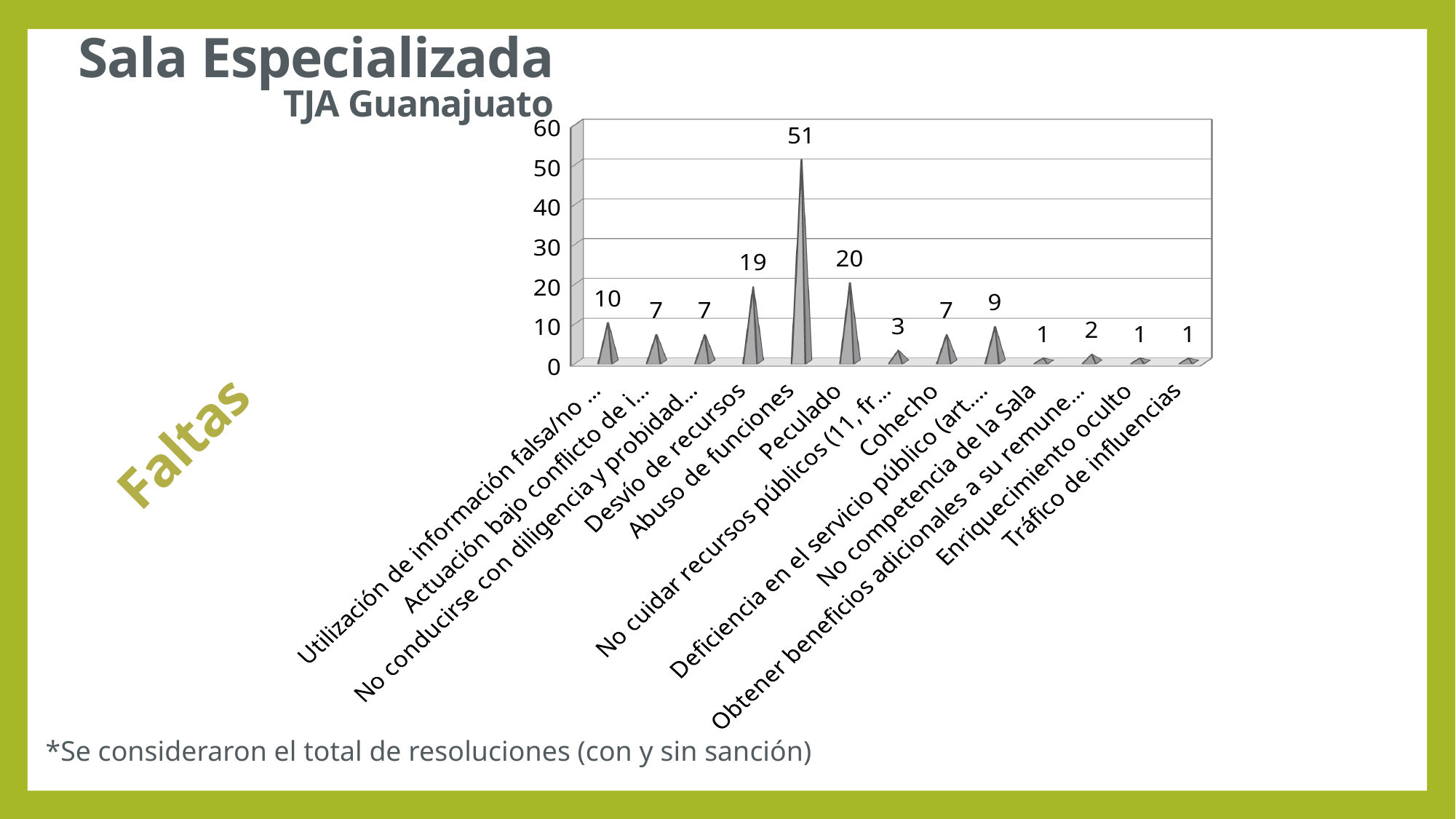
Which is larger, the value for No competencia de la Sala or the value for Cohecho? Cohecho What is the value for No competencia de la Sala? 1 What is the value for Desvío de recursos? 19 What is the value for Tráfico de influencias? 1 What is the value for Cohecho? 7 What is the value for Peculado? 20 What is the highest value shown on the vertical axis? 60 What is the value for Abuso de funciones? 51 What is the difference between the values for Abuso de funciones and Peculado? 31 Which category has the highest value? Abuso de funciones What is the difference between the values for Peculado and Desvío de recursos? 1 How many categories are plotted in the chart? 13